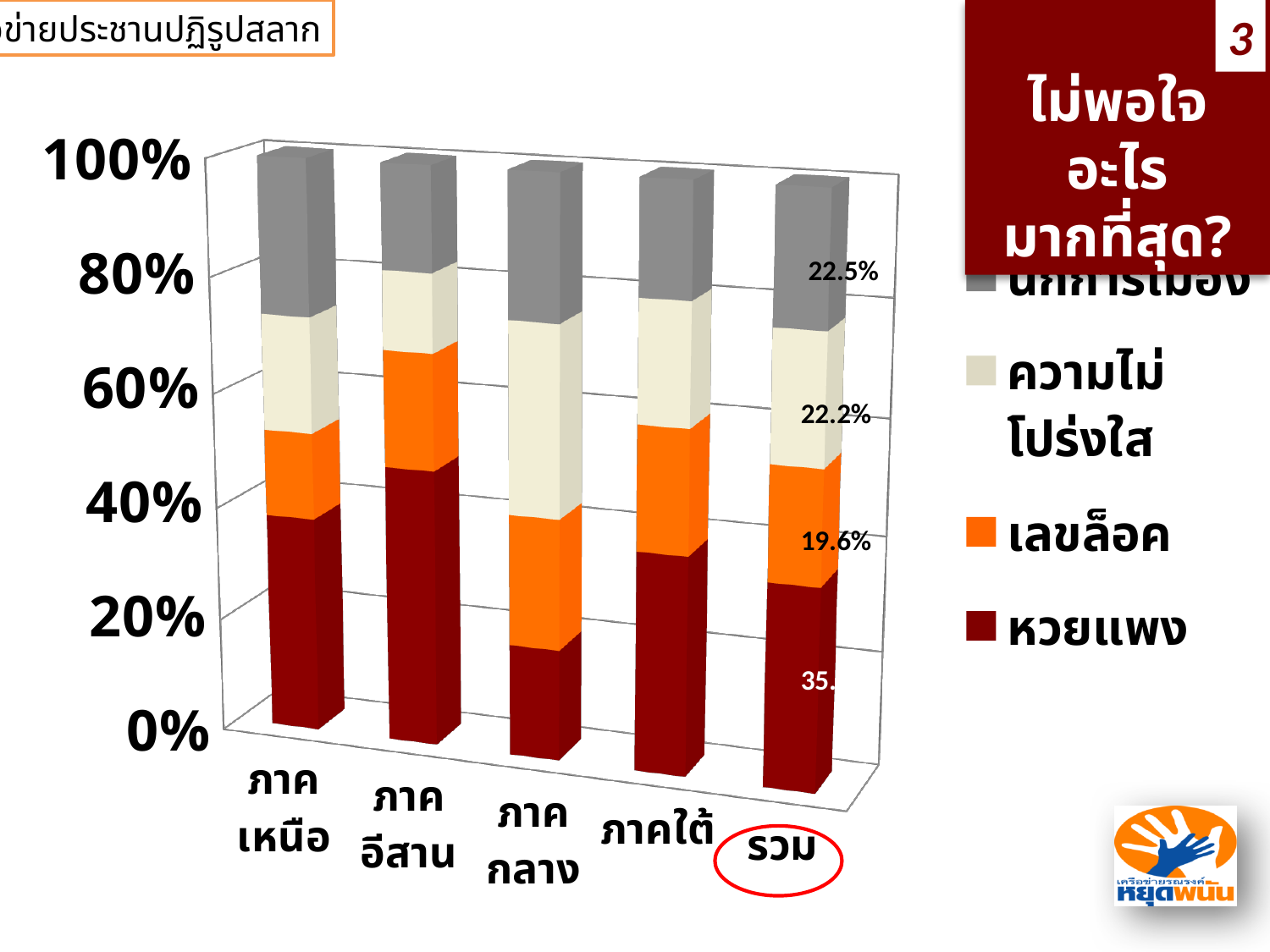
What is the value of the เลขล็อค segment for รวม? 19.6% How many series does the chart's legend list? 4 For รวม, which is larger: the นักการเมือง segment or the เลขล็อค segment? นักการเมือง Which category label on the x axis is circled in red? รวม What is the value of the ความไม่โปร่งใส segment for รวม? 22.2% Which category has the smallest หวยแพง segment? ภาคกลาง What is the value of the นักการเมือง segment for รวม? 22.5% How many categories are shown along the x axis of the chart? 5 Which category has the largest หวยแพง segment? ภาคอีสาน For รวม, what is the difference between the นักการเมือง segment (22.5%) and the เลขล็อค segment (19.6%)? 2.9% What kind of chart is shown on the slide? stacked bar chart